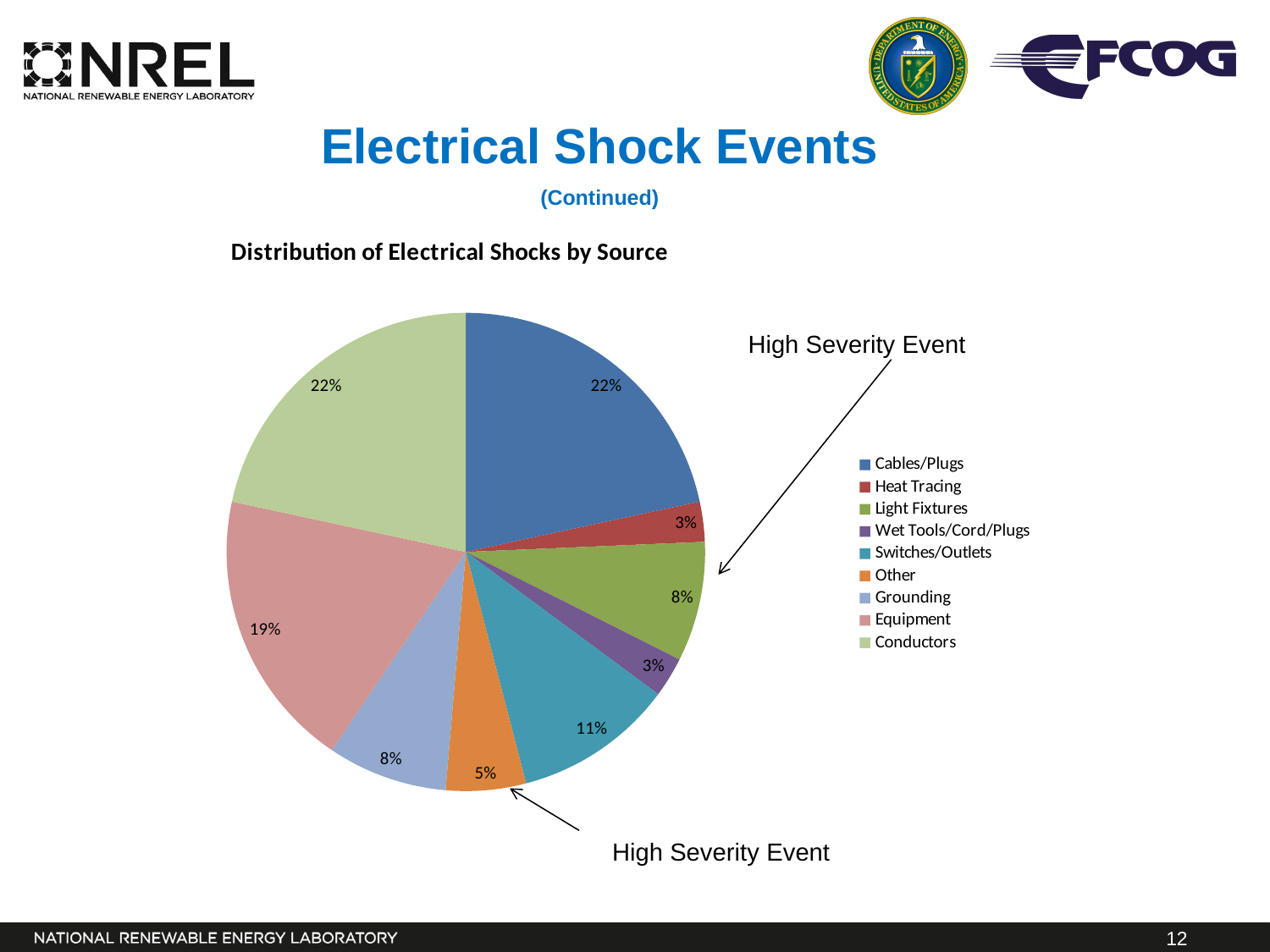
What share of electrical shocks is attributed to Grounding? 8% How many source categories are shown in the pie chart? 9 What type of chart is shown on the slide? Pie chart Which two slices are annotated as a High Severity Event? Light Fixtures and Other What share of electrical shocks is attributed to Cables/Plugs? 22% What is the difference between the share for Conductors and the share for Equipment? 3% What share of electrical shocks is attributed to Switches/Outlets? 11% What is the title of the chart? Distribution of Electrical Shocks by Source Which is larger, the share for Equipment or the share for Switches/Outlets? Equipment